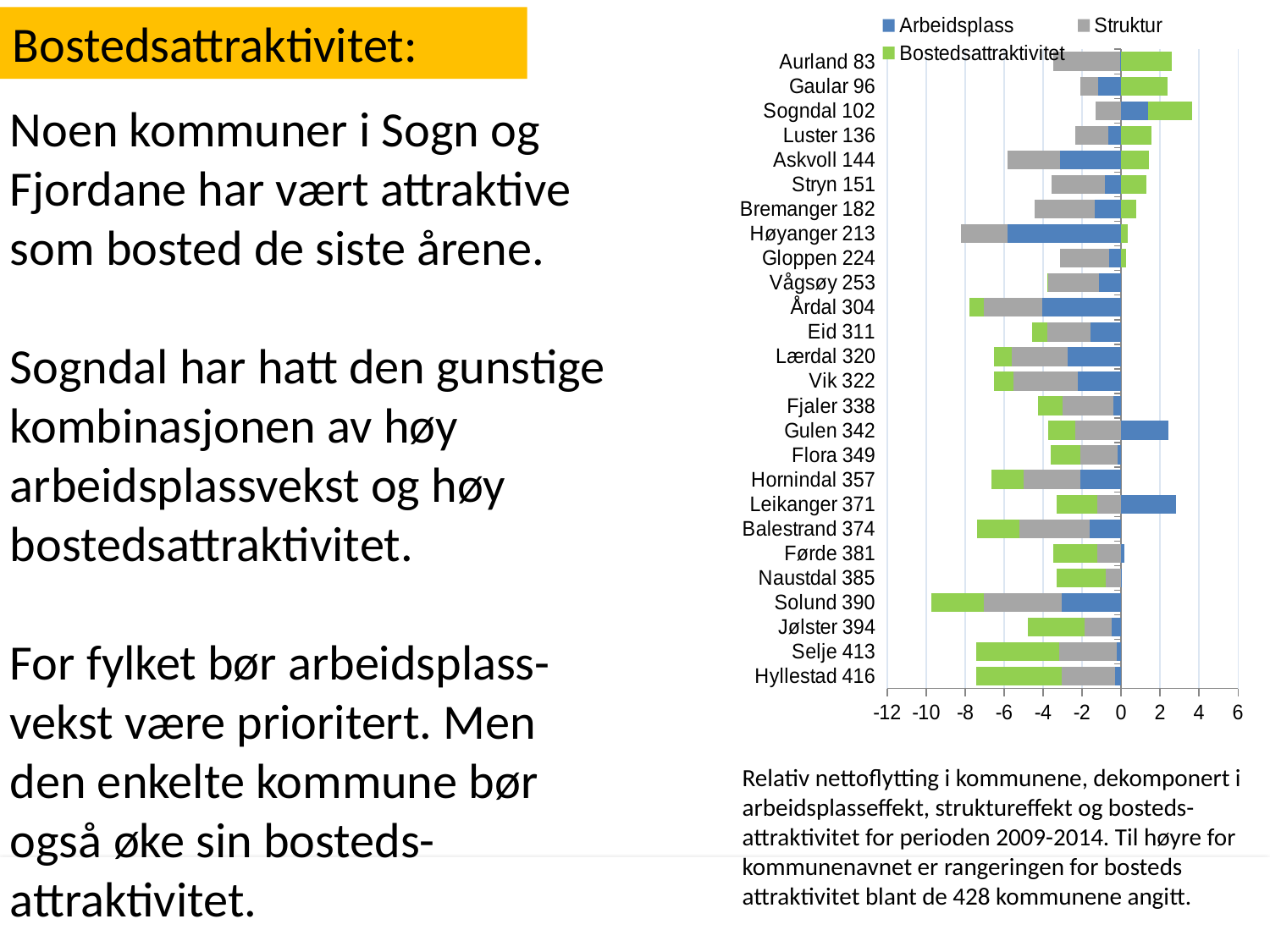
How many series does the chart's legend list? 3 Is the Struktur value for Hyllestad 416 greater or less than 0? less What kind of chart is shown on the slide? Stacked bar chart How many municipalities (categories) are plotted in the chart? 26 Which series in the chart is shown in green? Bostedsattraktivitet Which municipality is listed at the top of the chart? Aurland 83 Which is larger, the Arbeidsplass value for Leikanger 371 or for Askvoll 144? Leikanger 371 Is the Bostedsattraktivitet value for Sogndal 102 greater or less than 0? greater Is the Arbeidsplass value for Leikanger 371 greater or less than 2? greater Which municipality has the longest total negative bar in the chart? Solund 390